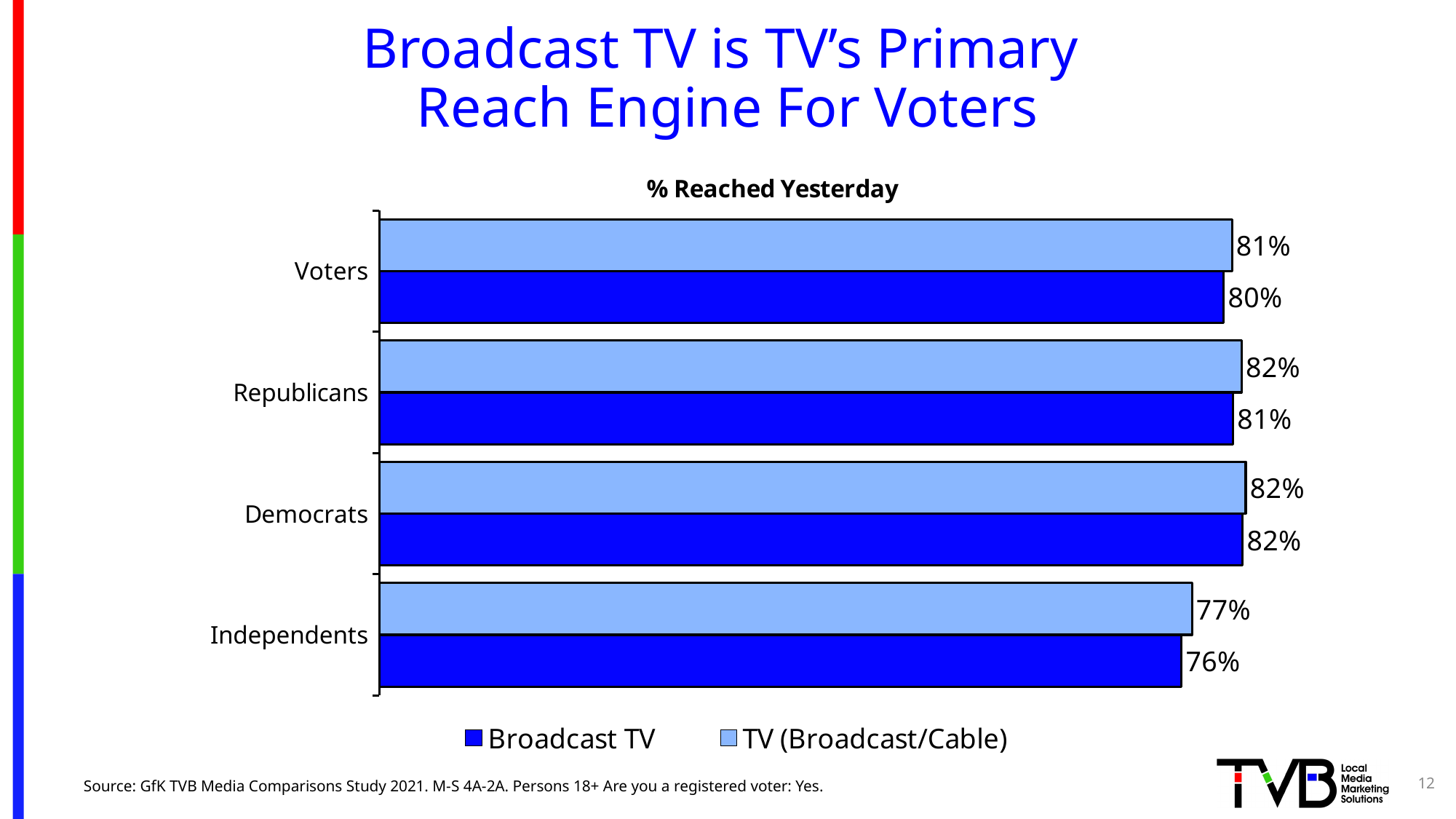
How many series does the legend list? 2 What is the Broadcast TV value for Independents? 76% Which category has the lowest TV (Broadcast/Cable) value? Independents What is the TV (Broadcast/Cable) value for Republicans? 82% What is the title of the chart? % Reached Yesterday What is the TV (Broadcast/Cable) value for Democrats? 82% What is the difference between the Broadcast TV values for Democrats and Independents? 6% What is the Broadcast TV value for Voters? 80% Which category has the lowest Broadcast TV value? Independents What is the difference between the TV (Broadcast/Cable) and Broadcast TV values for Independents? 1% How many categories are shown on the chart? 4 What kind of chart is shown on the slide? Bar chart